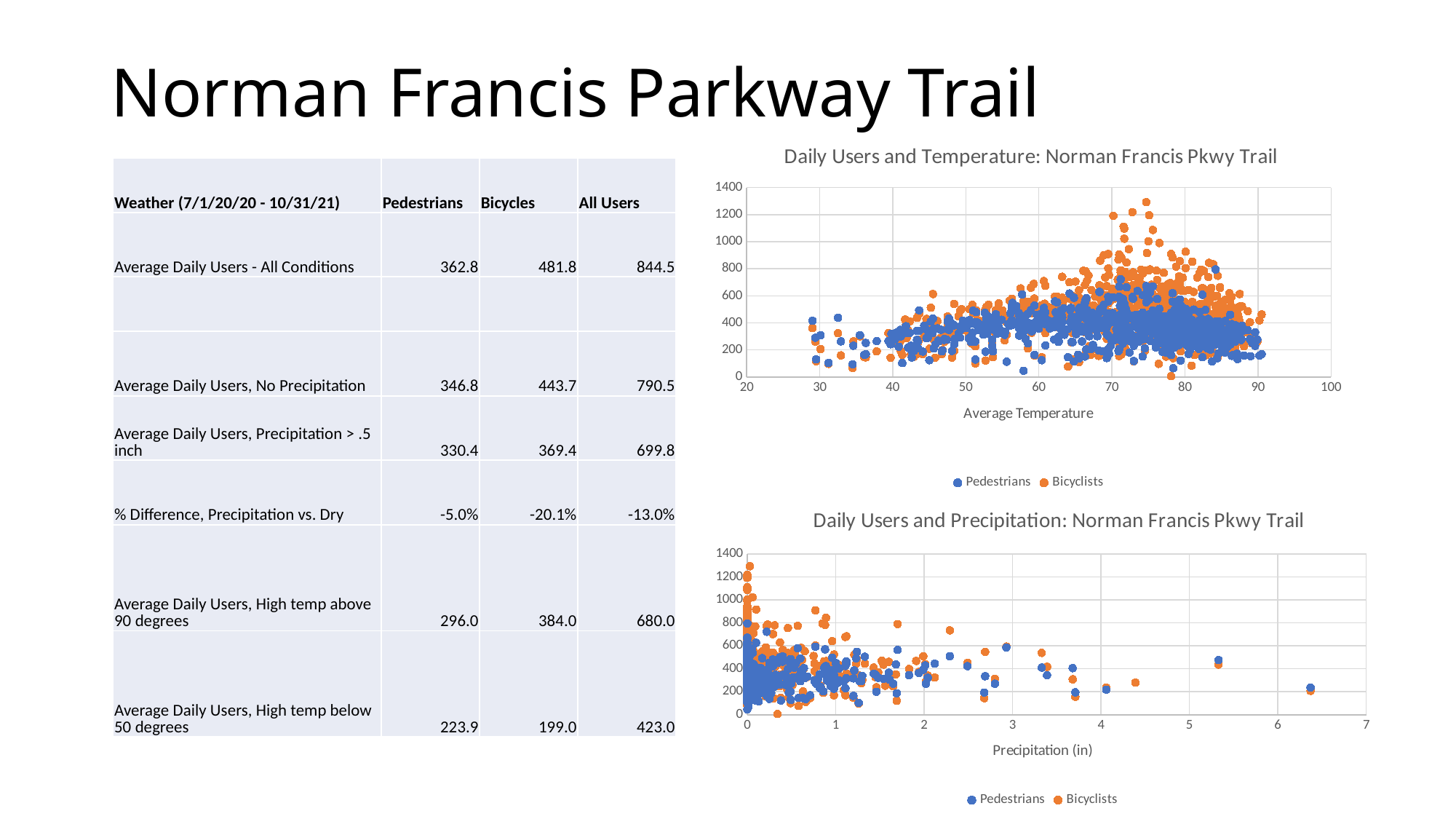
In the 'Daily Users and Temperature' chart, is the highest Bicyclists value greater or less than 1200? greater How many series does the legend of the 'Daily Users and Precipitation' chart list? 2 In the 'Daily Users and Temperature' chart, which series reaches the higher maximum value, Pedestrians or Bicyclists? Bicyclists In the 'Daily Users and Precipitation' chart, are the points plotted at about 6.4 inches of precipitation greater or less than 400? less What kind of chart is the 'Daily Users and Precipitation: Norman Francis Pkwy Trail' chart? scatter chart In the 'Daily Users and Precipitation' chart, do the highest daily user values generally rise or fall as precipitation increases along the x axis? fall In the 'Daily Users and Precipitation' chart, which colour represents the Bicyclists series? orange What kind of chart is the 'Daily Users and Temperature: Norman Francis Pkwy Trail' chart? scatter chart How many series does the legend of the 'Daily Users and Temperature' chart list? 2 In the 'Daily Users and Temperature' chart, what is the label of the x axis? Average Temperature In the 'Daily Users and Precipitation' chart, is the highest Bicyclists value greater or less than 1200? greater